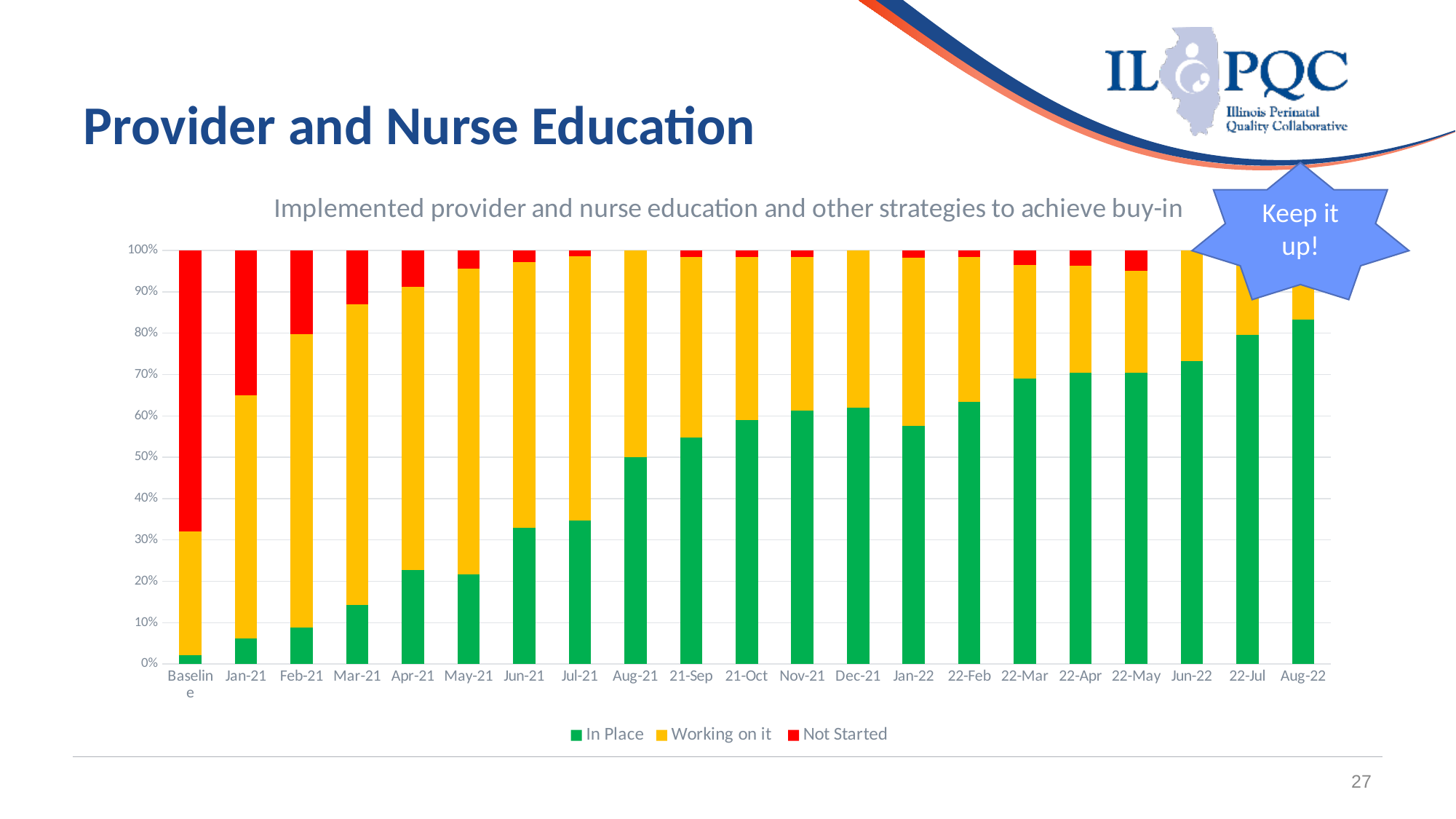
Which has the larger In Place share, Jun-21 or Dec-21? Dec-21 Is the Not Started value for Baseline greater or less than 60%? greater Is the In Place value for Aug-22 greater or less than 70%? greater What kind of chart is shown on the slide? Stacked bar chart Is the In Place value for Jan-21 greater or less than 10%? less How many series does the legend list? 3 What are the three series named in the legend? In Place, Working on it, Not Started Which category has the lowest In Place share? Baseline Which category has the largest Not Started share? Baseline How many time-period categories are shown on the x axis? 21 Which category has the highest In Place share? Aug-22 Does the In Place share generally rise or fall from Baseline to Aug-22? Rise